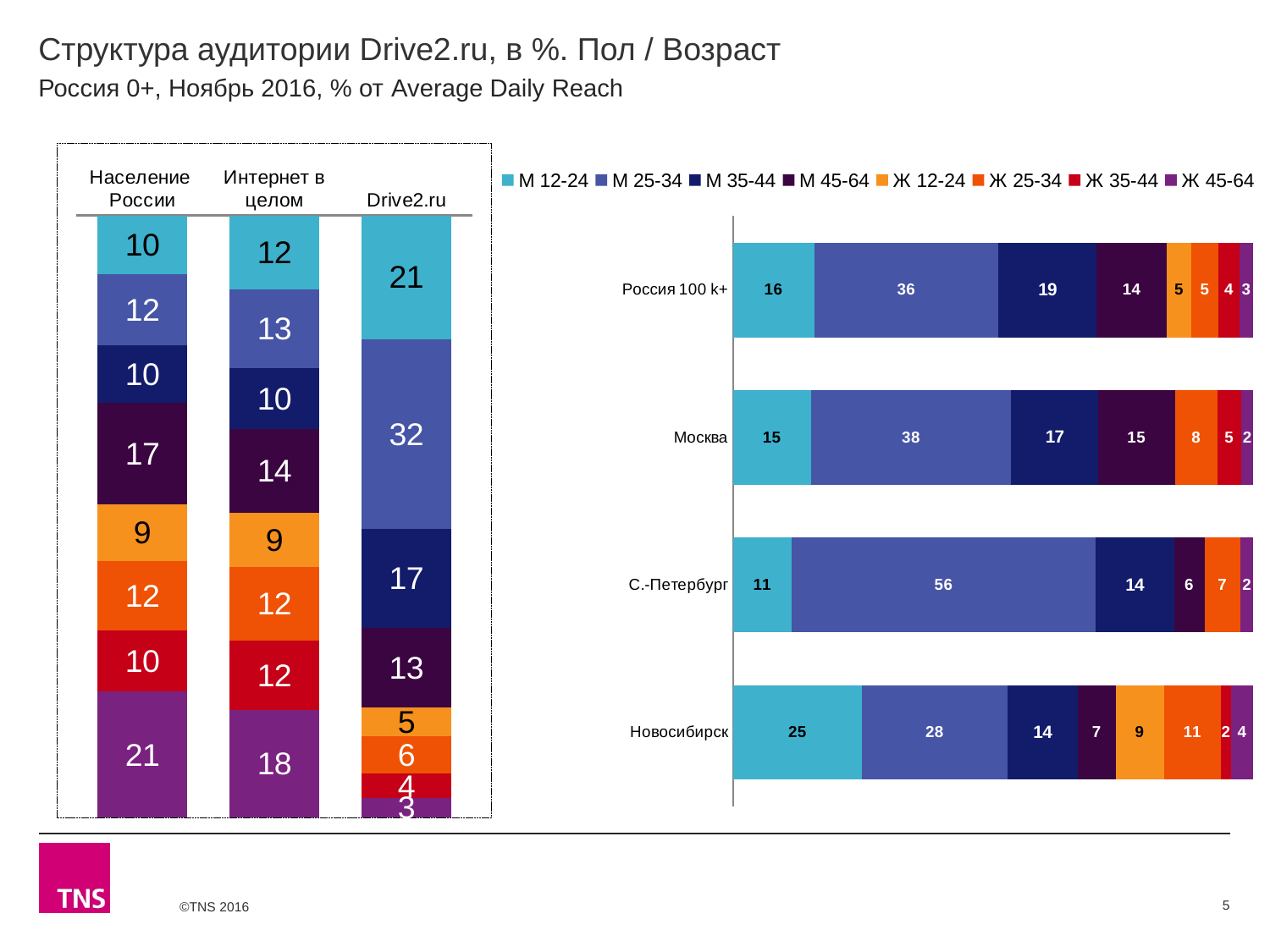
In the right chart, what is the value of the М 12-24 segment for Новосибирск? 25 In the left chart, what is the value of the Ж 45-64 segment for Население России? 21 In the right chart, which city has the largest М 25-34 segment? С.-Петербург How many categories (bars) are shown in the right chart? 4 How many series does the legend of the right chart list? 8 In the left chart, what is the value of the М 25-34 segment for Drive2.ru? 32 What type of chart is the right chart? Stacked bar chart In the left chart, which column has the smallest Ж 45-64 segment? Drive2.ru In the left chart, what is the total of the Drive2.ru column? 101 In the right chart, what is the value of the М 25-34 segment for С.-Петербург? 56 In the right chart, what is the difference between the М 25-34 values for Москва and Россия 100 k+? 2 In the left chart, is the М 12-24 segment larger for Drive2.ru or for Интернет в целом? Drive2.ru